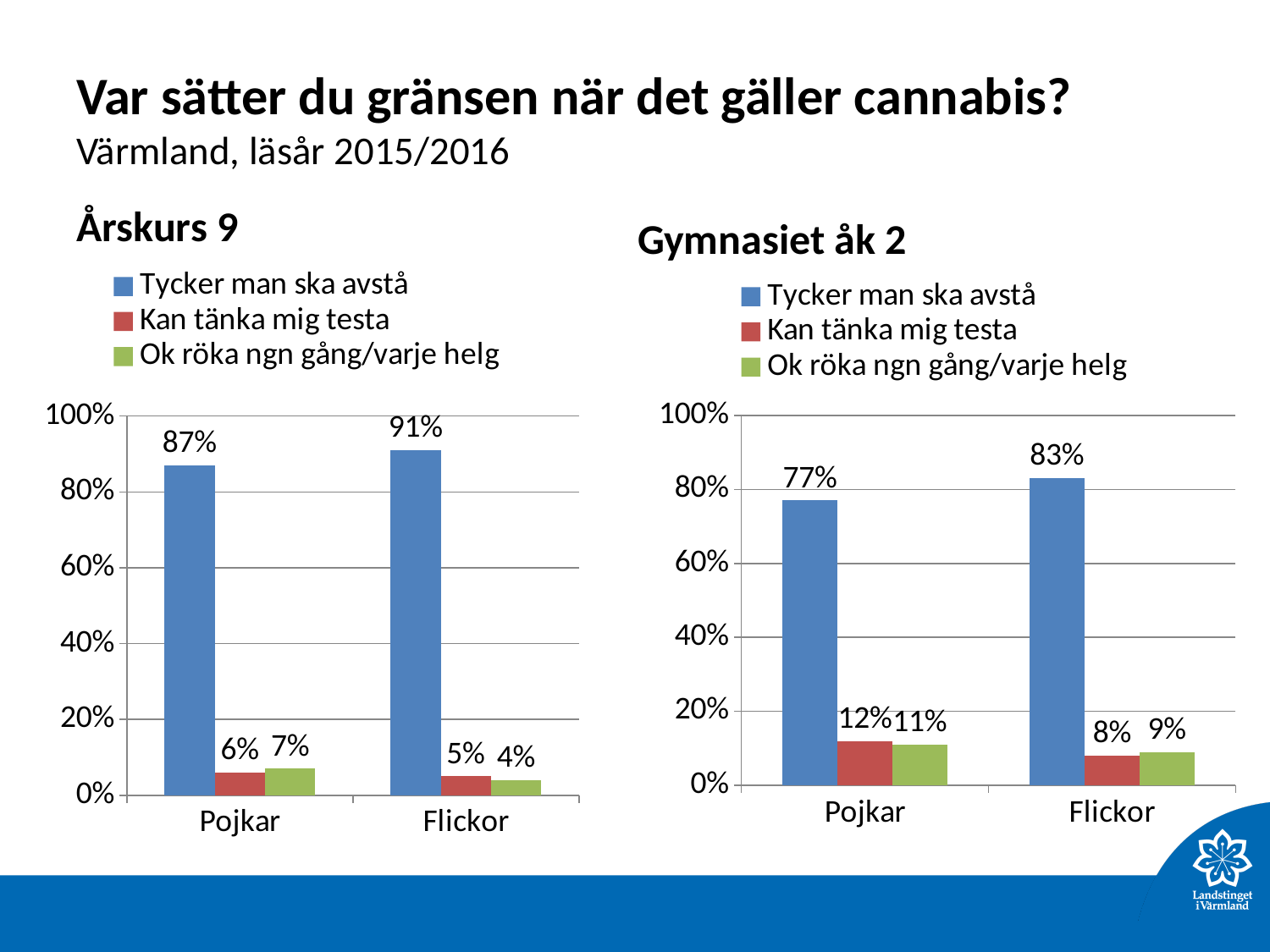
How many categories are shown on the x axis of the Årskurs 9 chart? 2 In the Gymnasiet åk 2 chart, what is the value for Tycker man ska avstå for Flickor? 83% In the Årskurs 9 chart, what is the value for Tycker man ska avstå for Pojkar? 87% In the Årskurs 9 chart, which series has the lowest value for Flickor? Ok röka ngn gång/varje helg In the Årskurs 9 chart, which category has the highest value for Tycker man ska avstå? Flickor In the Gymnasiet åk 2 chart, what is the difference between Tycker man ska avstå for Flickor and for Pojkar? 6% What kind of chart is the Gymnasiet åk 2 chart? Bar chart In the Årskurs 9 chart, what is the difference between Tycker man ska avstå for Flickor and for Pojkar? 4% In the Gymnasiet åk 2 chart, what is the value for Kan tänka mig testa for Pojkar? 12% In the Årskurs 9 chart, what is the value for Ok röka ngn gång/varje helg for Flickor? 4% In the Gymnasiet åk 2 chart, which is larger for Pojkar: Kan tänka mig testa or Ok röka ngn gång/varje helg? Kan tänka mig testa How many series does the legend of the Gymnasiet åk 2 chart list? 3